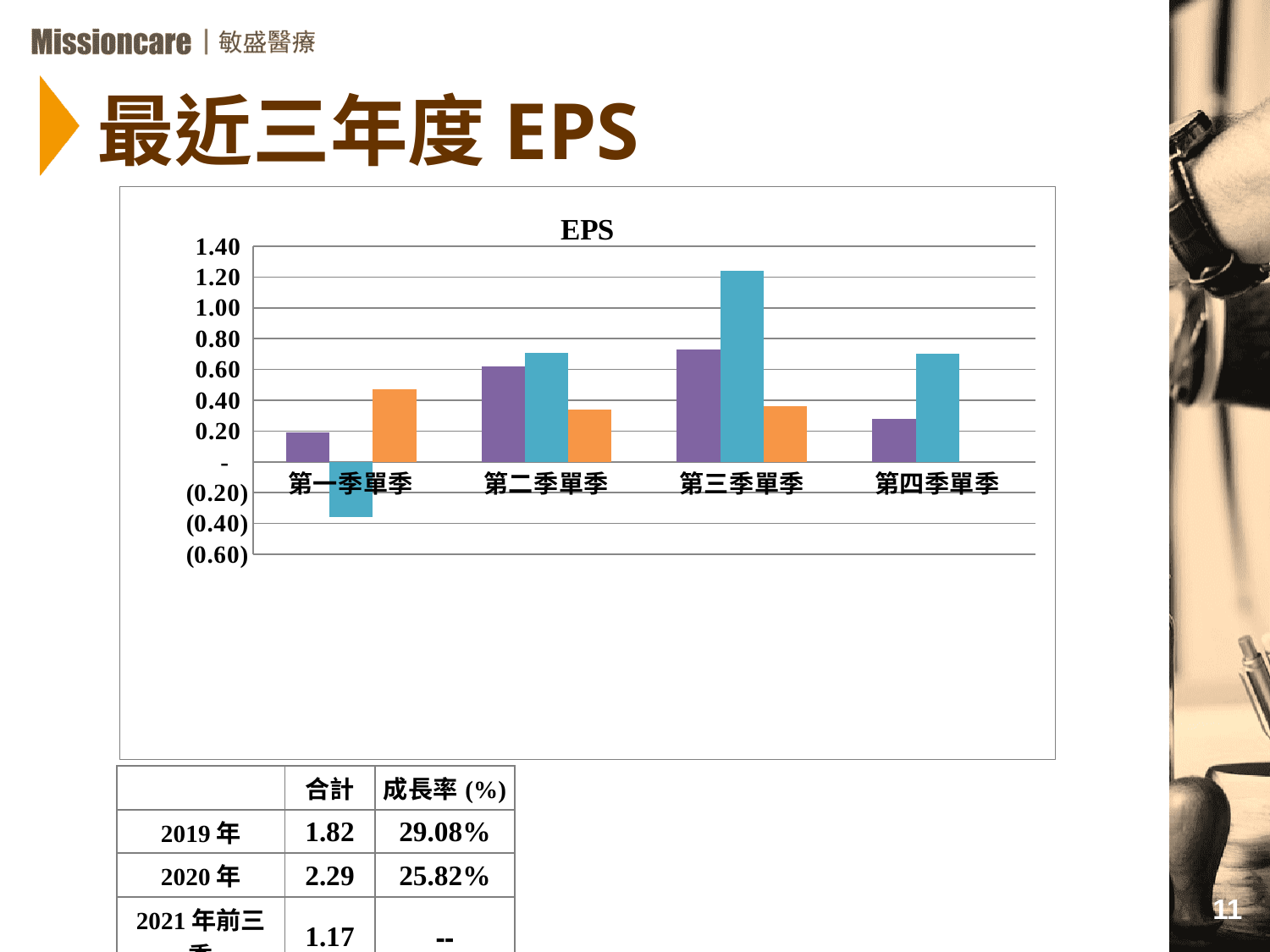
How many quarter categories are shown on the x axis of the chart? 4 What kind of chart is shown on the slide? bar chart Is the value of the blue bar for 第一季單季 greater or less than 0.20? less Is the value of the blue bar for 第四季單季 greater or less than 0.60? greater How many bars are plotted for 第四季單季? 2 Is the value of the blue bar for 第三季單季 greater or less than 1.00? greater Among the purple bars, which quarter has the lowest value? 第一季單季 For 第三季單季, which is larger: the purple bar or the orange bar? the purple bar Among the blue bars, which quarter has the highest value? 第三季單季 What is the title of the chart? EPS